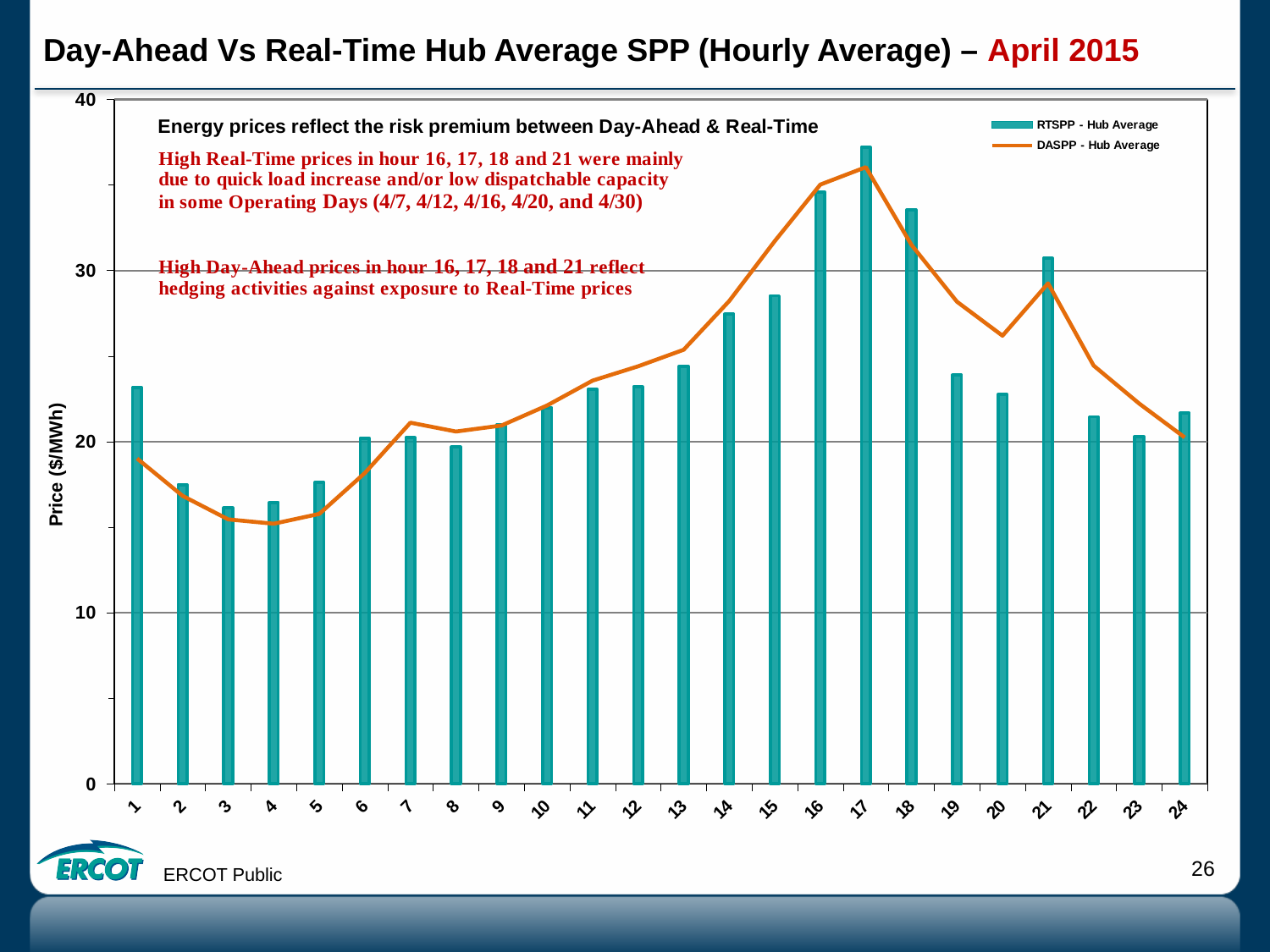
How many hours are shown along the x axis? 24 What are the two series named in the legend? RTSPP - Hub Average and DASPP - Hub Average Do the RTSPP - Hub Average bars rise or fall from hour 13 to hour 17? rise What is the label on the y axis? Price ($/MWh) Is the DASPP - Hub Average value for hour 4 greater or less than 20? less In hour 1, which is larger: RTSPP - Hub Average or DASPP - Hub Average? RTSPP - Hub Average How many series does the legend list? 2 Is the RTSPP - Hub Average value for hour 17 greater or less than 30? greater Is the RTSPP - Hub Average value for hour 3 greater or less than 20? less In which hour is the RTSPP - Hub Average bar highest? 17 What kind of chart is this? A bar chart with a line series overlaid In which hour does the DASPP - Hub Average line reach its highest point? 17